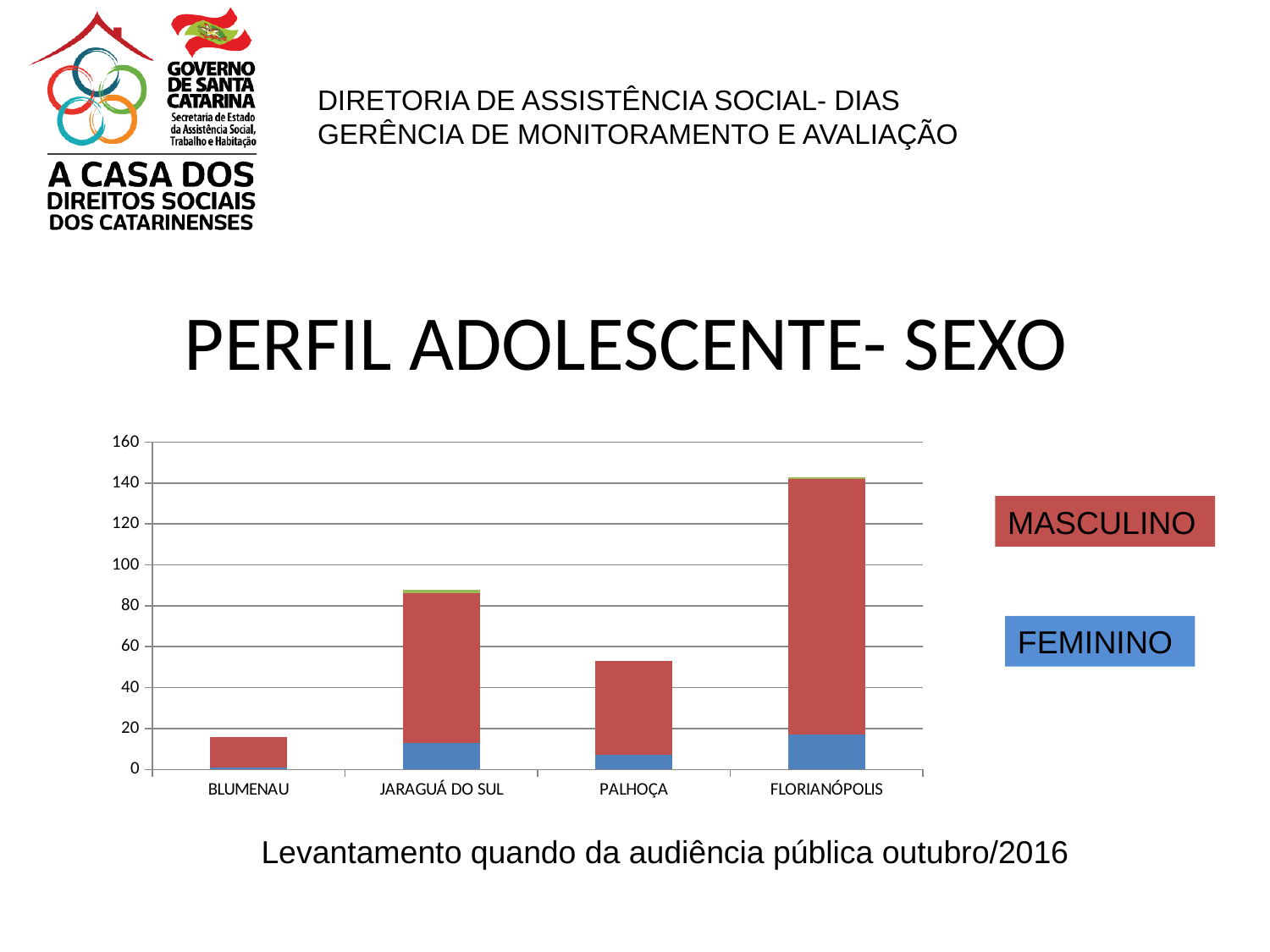
How many cities are shown on the x axis of the chart? 4 Is the total bar height for PALHOÇA greater or less than 60? less Is the total bar height for JARAGUÁ DO SUL greater or less than 80? greater How many series does the legend list? 2 Which city has the shortest bar in the chart? BLUMENAU Which city has the tallest bar in the chart? FLORIANÓPOLIS What kind of chart is shown on the slide? bar chart Which colour represents the MASCULINO series in the chart? red What is the title of the chart on the slide? PERFIL ADOLESCENTE- SEXO Which bar is taller, JARAGUÁ DO SUL or PALHOÇA? JARAGUÁ DO SUL Is the total bar height for FLORIANÓPOLIS greater or less than 120? greater